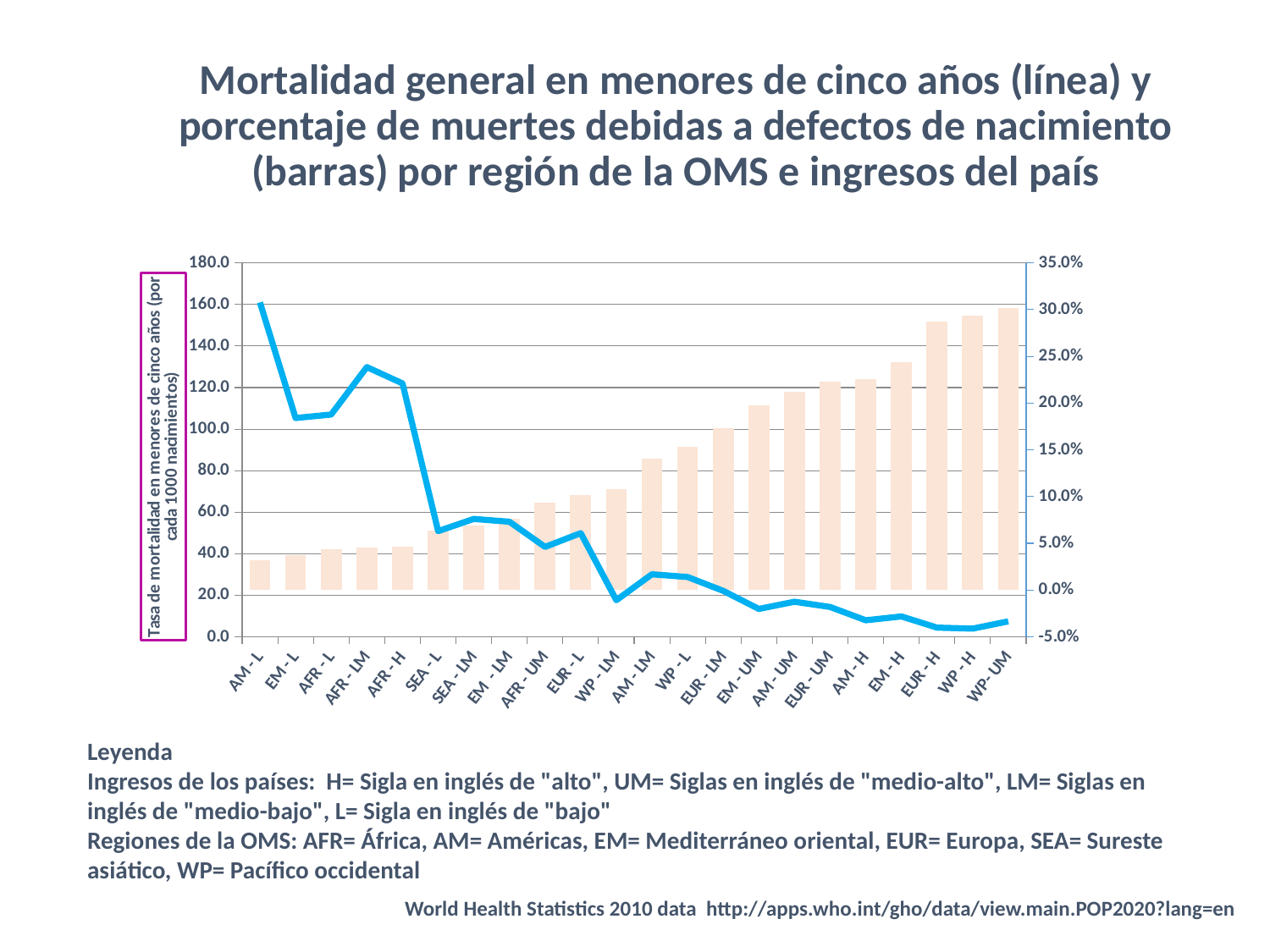
How many region-income categories are shown along the x axis? 22 Which category has the highest value on the line (mortality rate)? AM - L Is the bar value for AM - L greater or less than 5.0%? less Which category has the shortest bar? AM - L Do the line values generally rise or fall from left to right along the x axis? fall What kind of chart is shown on the slide? A combined bar and line chart Is the bar value for WP- UM greater or less than 25.0%? greater Which has the larger line value, AM - L or EM - L? AM - L Is the line value for SEA - L greater or less than 60? less Do the bar values generally rise or fall from left to right along the x axis? rise Which category has the tallest bar (percentage of deaths due to birth defects)? WP- UM